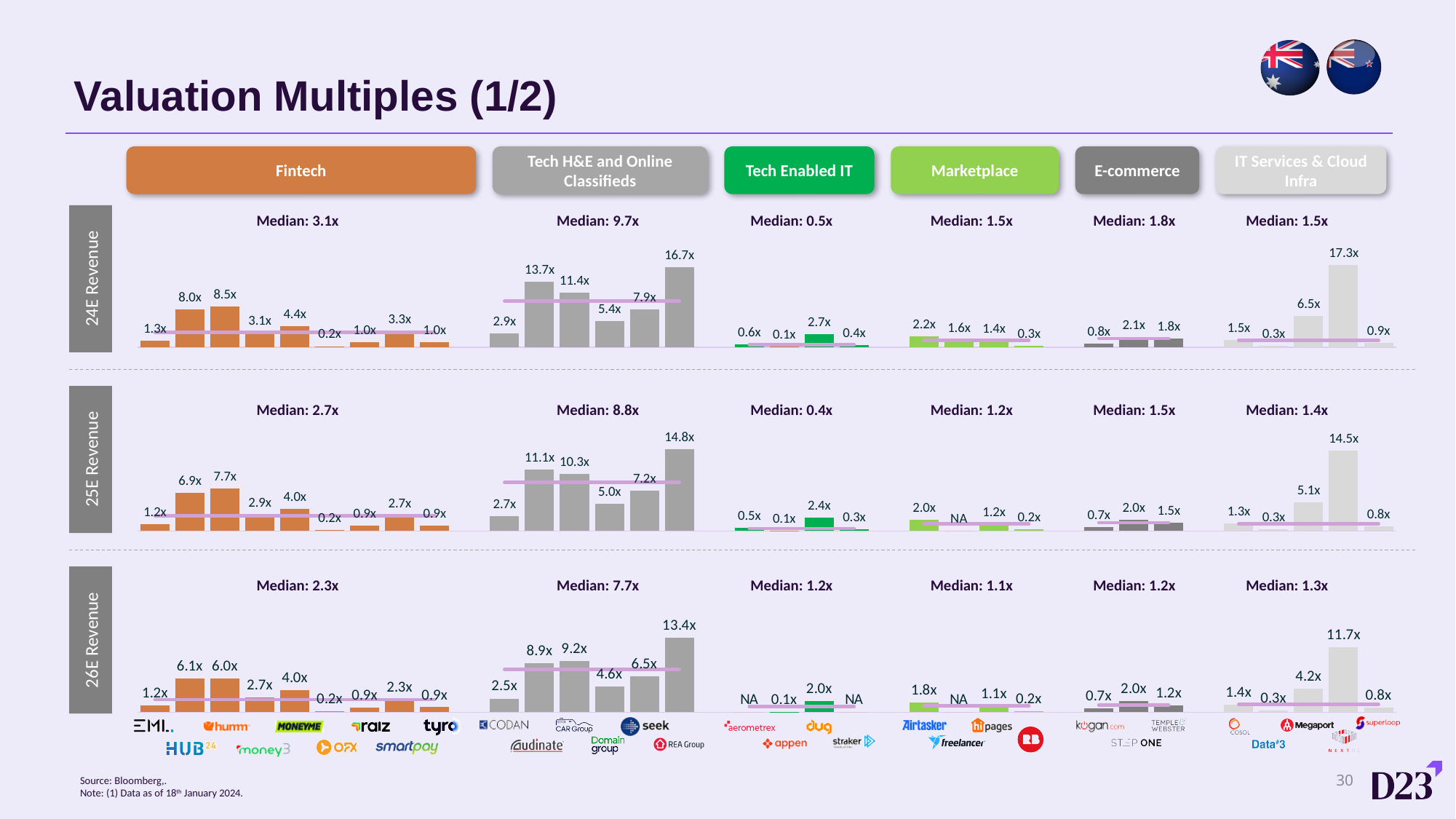
How many bars are plotted in the Tech H&E and Online Classifieds group of the 26E Revenue row? 6 What is the difference between the highest Tech H&E and Online Classifieds multiple in the 24E Revenue row (16.7x) and the highest in the 25E Revenue row (14.8x)? 1.9x In the 24E Revenue row, which group has the larger median: Fintech or Marketplace? Fintech In the 24E Revenue row, what is the median valuation multiple shown for the Fintech group? 3.1x Does the median for Tech H&E and Online Classifieds rise or fall from the 24E Revenue row to the 26E Revenue row? Fall How many sector groups are shown across the top of the slide? 6 In the 25E Revenue row, what is the lowest multiple shown in the Fintech group? 0.2x What kind of chart is used to show the valuation multiples on this slide? Bar chart How many bars are plotted in the Fintech group of the 24E Revenue row? 9 In the 26E Revenue row, what is the highest multiple shown in the IT Services & Cloud Infra group? 11.7x In the 24E Revenue row, what is the highest multiple shown in the Tech H&E and Online Classifieds group? 16.7x In the 25E Revenue row, what is the median multiple shown for the Tech Enabled IT group? 0.4x